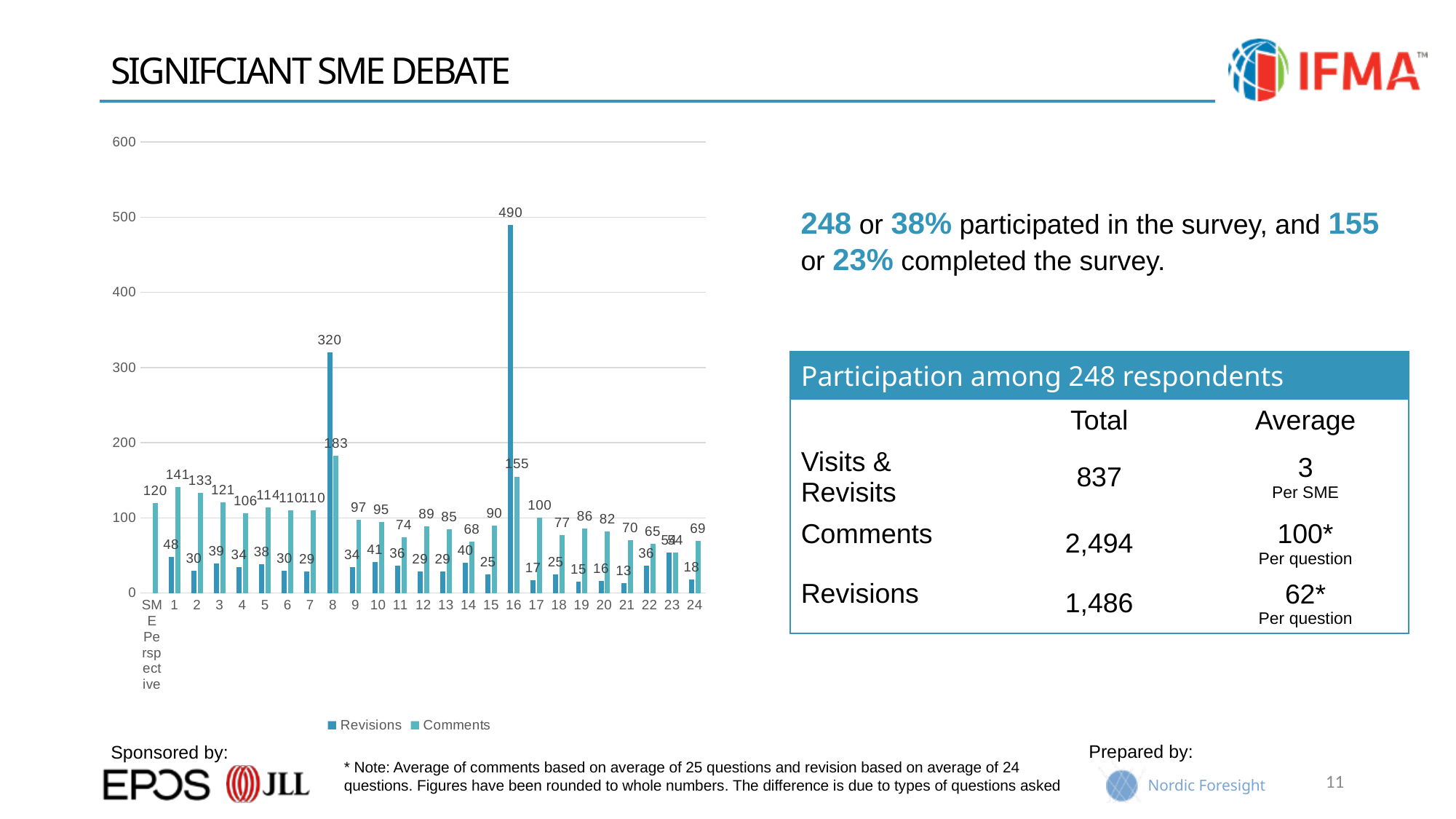
Which question has the lowest Revisions value? 21 Which question has the highest Revisions value? 16 Which has more Comments, question 1 or question 2? question 1 What is the Revisions value for question 16? 490 What kind of chart is shown on the slide? bar chart What is the Comments value for question 8? 183 What is the difference between the Revisions and Comments values for question 16? 335 What is the Comments value for the SME Perspective category? 120 Which category has the highest Comments value? 8 What are the two series named in the chart's legend? Revisions and Comments How many series does the chart's legend list? 2 Is the Revisions value for question 8 greater or less than 300? greater